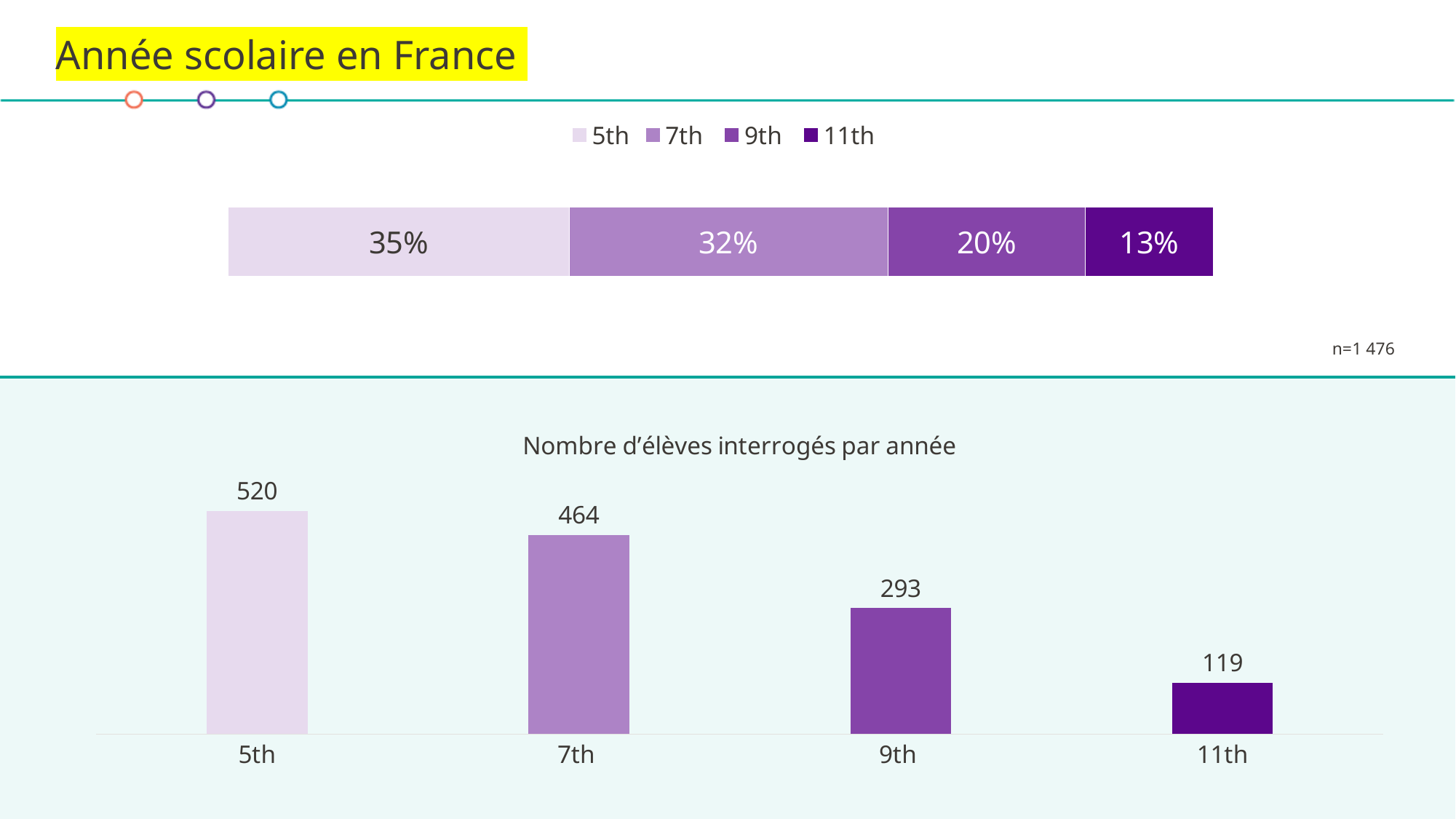
In the top stacked bar chart, how many series does the legend list? 4 In the bottom chart 'Nombre d'élèves interrogés par année', do the values rise or fall from 5th to 11th? fall What kind of chart is the bottom chart 'Nombre d'élèves interrogés par année'? bar chart In the top stacked bar chart, what is the difference in percentage points between 5th and 9th? 15 In the bottom chart 'Nombre d'élèves interrogés par année', what is the difference between the values for 7th and 11th? 345 In the top stacked bar chart, what percentage is shown for 11th? 13% In the bottom chart 'Nombre d'élèves interrogés par année', what is the value for 5th? 520 In the bottom chart 'Nombre d'élèves interrogés par année', which is larger, the value for 7th or the value for 9th? 7th In the bottom chart 'Nombre d'élèves interrogés par année', which grade has the lowest number of students? 11th In the top stacked bar chart, which grade has the largest share? 5th In the top stacked bar chart, what percentage is shown for 7th? 32% In the bottom chart 'Nombre d'élèves interrogés par année', what is the value for 9th? 293